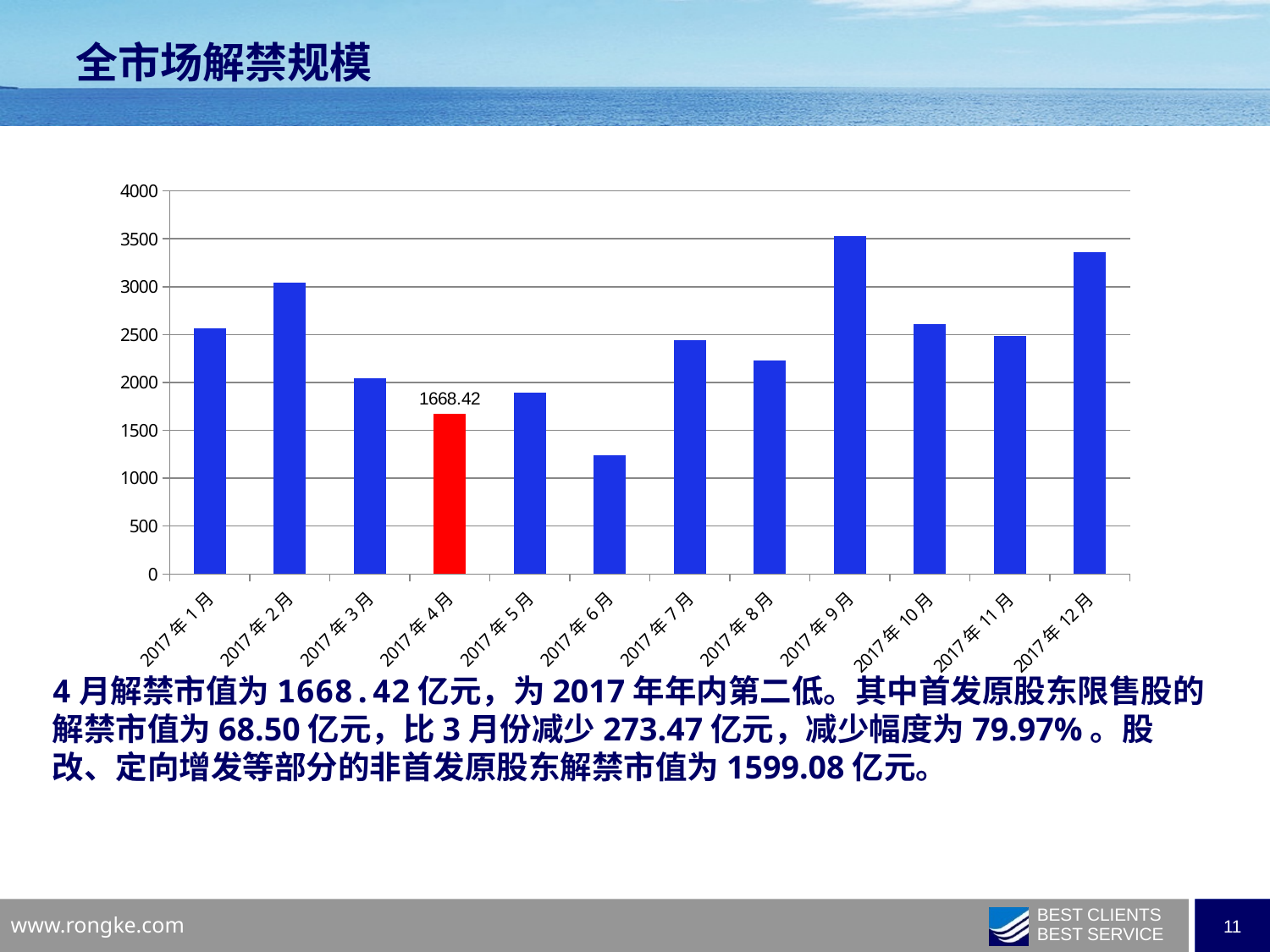
Is the value for 2017年2月 greater or less than 3000? greater Which month has the highest bar? 2017年9月 Which is larger, the value for 2017年7月 or 2017年8月? 2017年7月 How many months are plotted on the chart? 12 Is the value for 2017年6月 greater or less than 1500? less Which is larger, the value for 2017年2月 or 2017年12月? 2017年12月 Which month's bar is coloured red? 2017年4月 Is the value for 2017年12月 greater or less than 3000? greater What kind of chart is shown on the slide? Bar chart Which month has the lowest bar? 2017年6月 What is the value shown for 2017年4月? 1668.42